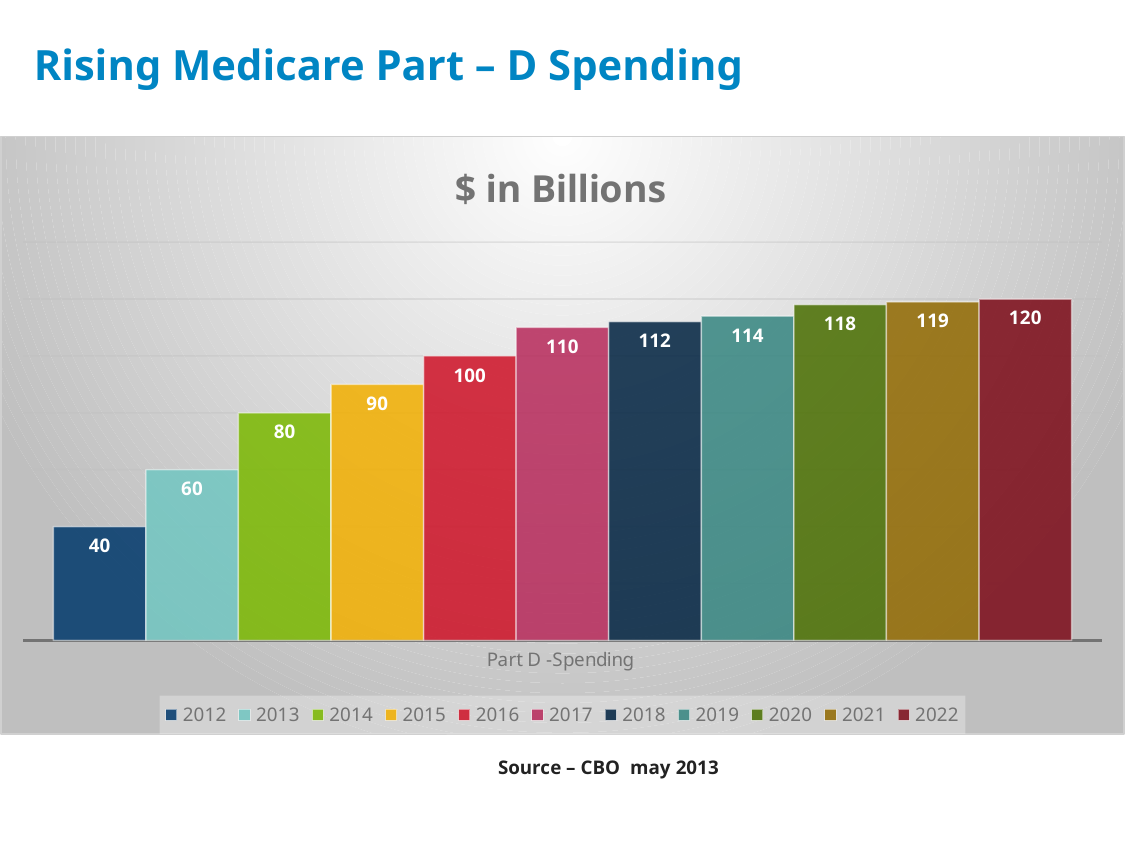
What is the Part D spending value for 2012? 40 What is the Part D spending value for 2021? 119 How many entries does the legend list? 11 What is the difference between the 2022 and 2012 values? 80 What is the Part D spending value for 2017? 110 How many years are shown in the chart? 11 What is the difference between the 2016 and 2014 values? 20 Which year has the highest Part D spending? 2022 Which is larger, the value for 2015 or the value for 2019? 2019 Which year has the lowest Part D spending? 2012 What kind of chart is shown on the slide? Bar chart Do the values rise or fall from 2012 to 2022? Rise